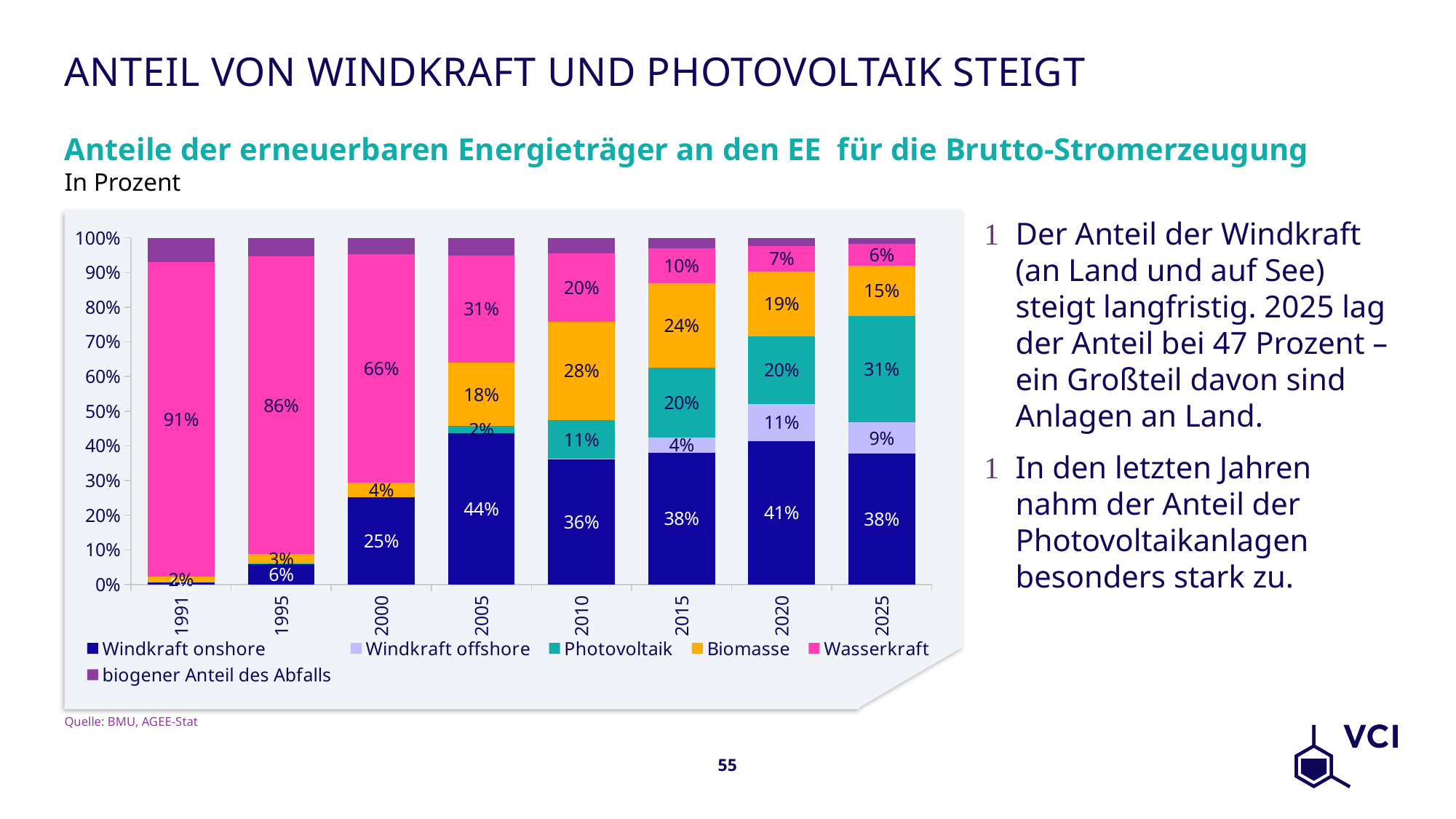
Does the Wasserkraft share rise or fall from 1991 to 2025? fall What is the Windkraft offshore share in 2020? 11% What is the Photovoltaik share in 2025? 31% Which is larger in 2015: the Biomasse share or the Photovoltaik share? Biomasse In which year is the Wasserkraft share lowest? 2025 How many series does the legend list? 6 What share does Wasserkraft have in 1991? 91% What is the Biomasse share in 2010? 28% In which year is the Windkraft onshore share highest? 2005 What is the combined share of Windkraft onshore and Windkraft offshore in 2025? 47% By how many percentage points did the Photovoltaik share change from 2020 to 2025? 11 percentage points How many years are shown on the x axis? 8